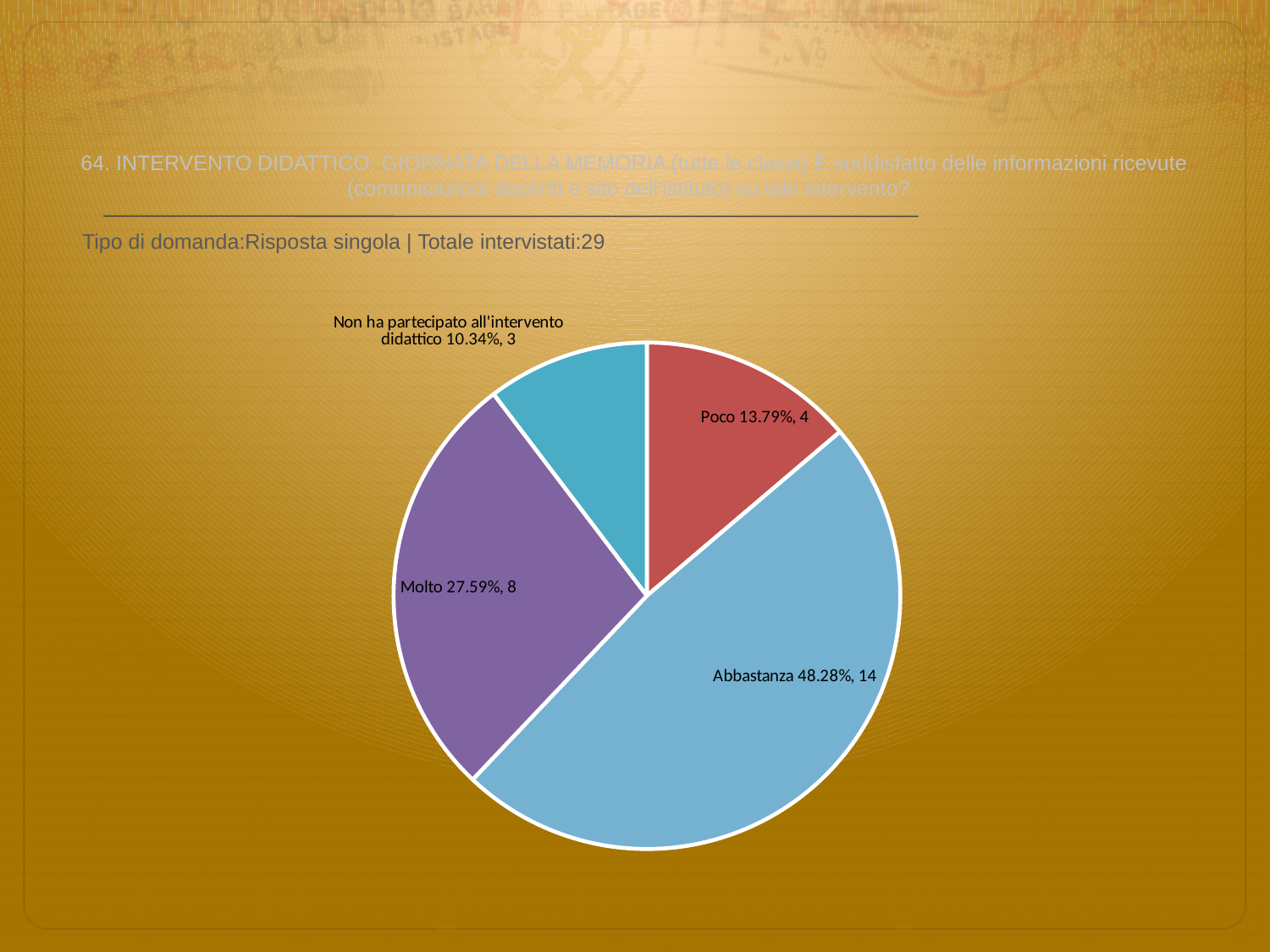
What colour is the 'Abbastanza' slice? light blue How many respondents answered 'Molto'? 8 What kind of chart is shown on the slide? pie chart What percentage share does the 'Non ha partecipato all'intervento didattico' slice have? 10.34% What is the difference in number of respondents between 'Abbastanza' and 'Molto'? 6 Which has more respondents, 'Poco' or 'Molto'? Molto What percentage share does the 'Abbastanza' slice have? 48.28% Which category has the smallest slice? Non ha partecipato all'intervento didattico What is the total number of respondents across all slices? 29 Which category has the largest slice? Abbastanza How many respondents answered 'Poco'? 4 How many slices does the pie chart have? 4